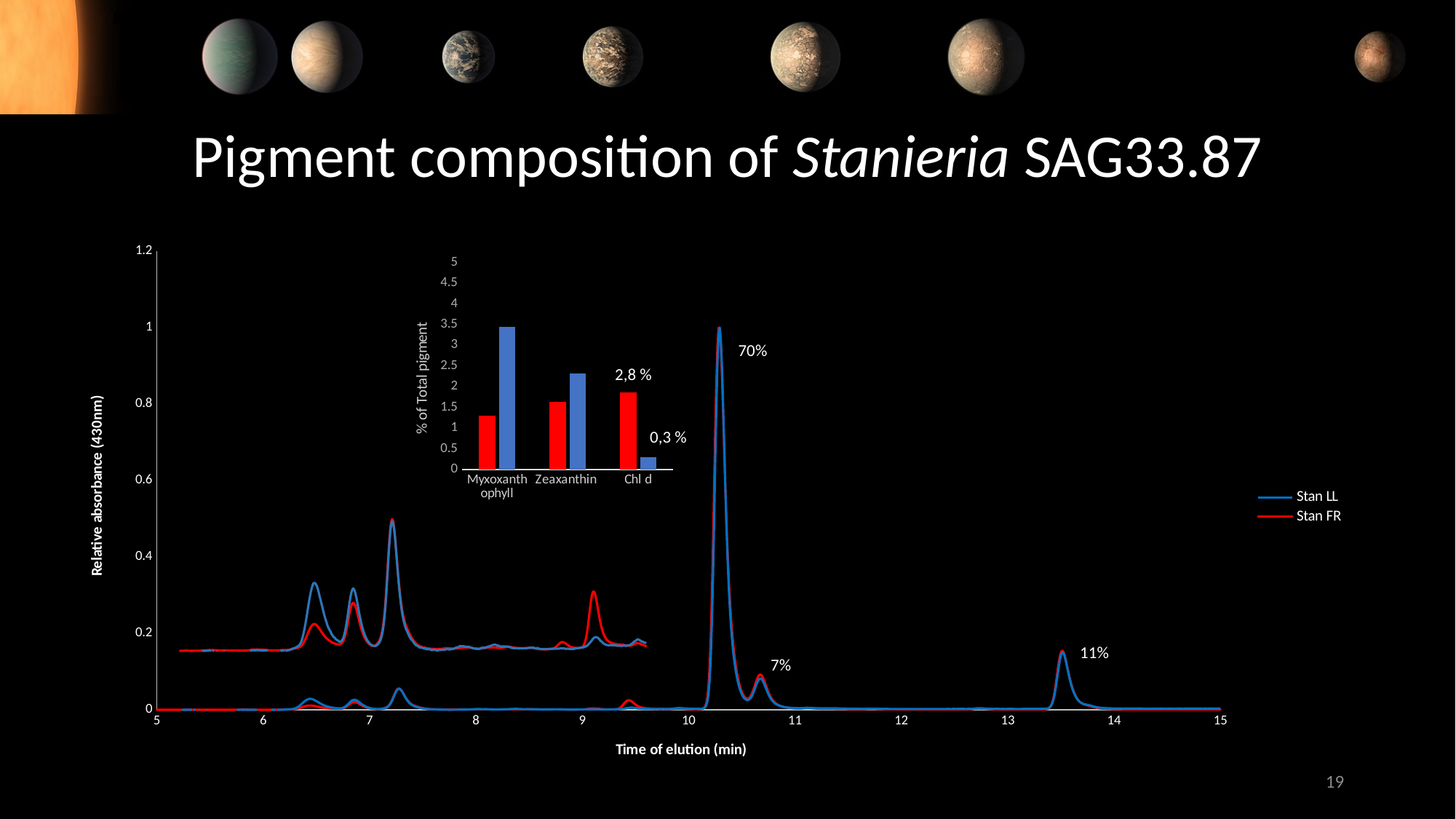
In the inset bar chart, how many pigment categories are shown on the x axis? 3 In the inset bar chart, what value is labelled on the blue bar for Chl d? 0,3 % In the inset bar chart, for Myxoxanthophyll, is the red bar or the blue bar larger? blue In the inset bar chart, is the red bar for Zeaxanthin greater or less than 2? less What kind of chart is the inset chart labelled '% of Total pigment'? bar chart In the inset bar chart, what is the difference between the red and blue bars for Chl d? 2,5 % In the inset bar chart, is the blue bar for Myxoxanthophyll greater or less than 3? greater In the large line chart, how many series does the legend list? 2 In the large line chart, what percentage label is shown next to the tallest peak at about 10.3 min? 70% In the inset bar chart, what value is labelled on the red bar for Chl d? 2,8 % What kind of chart is the large chart with the x axis 'Time of elution (min)'? line chart In the inset bar chart, which category has the tallest blue bar? Myxoxanthophyll